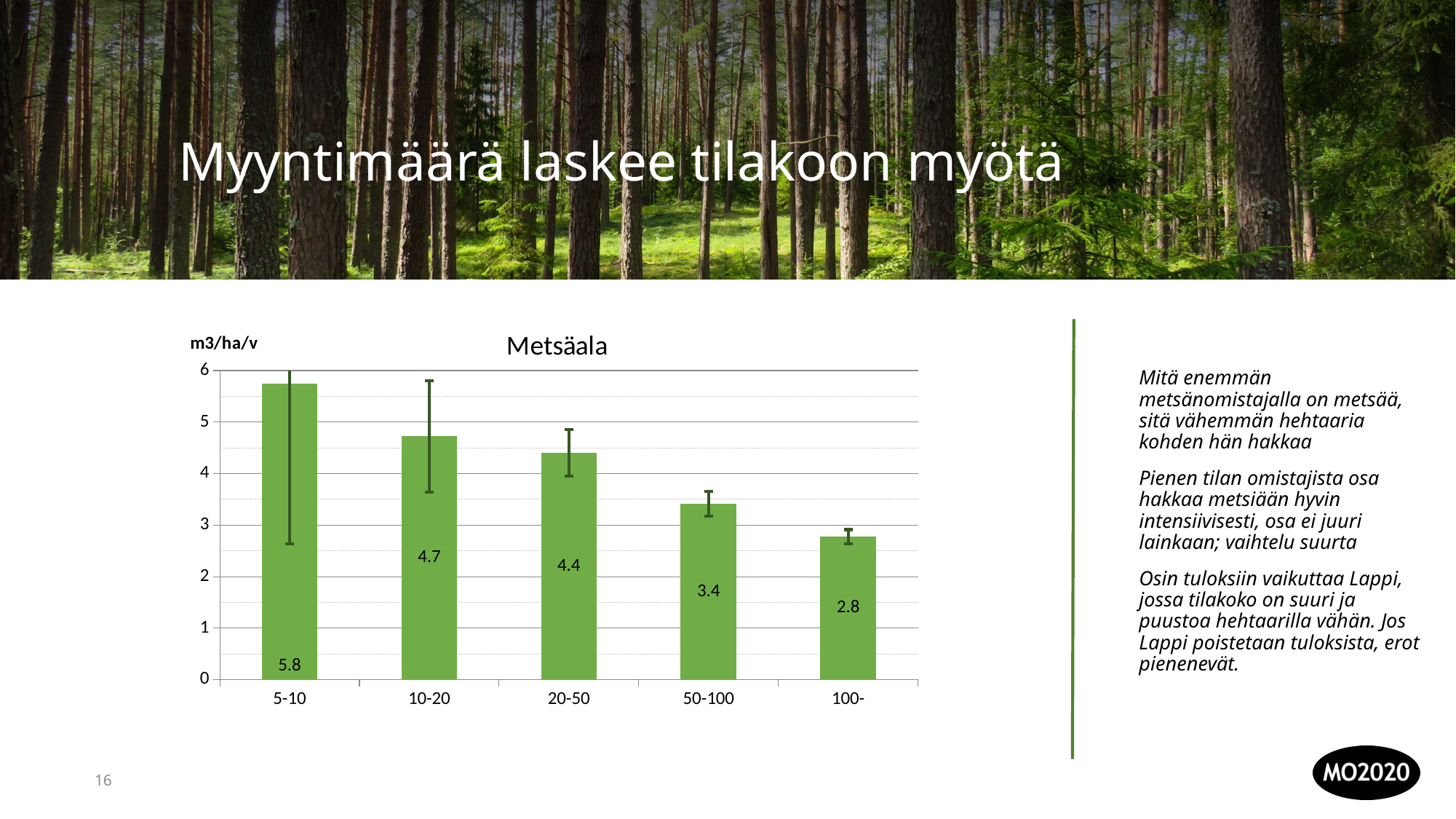
Do the values in the Metsäala chart rise or fall from left to right along the x axis? fall What is the value for the 50-100 category in the Metsäala chart? 3.4 What kind of chart is the Metsäala chart? bar chart What is the difference between the values for 5-10 and 100- in the Metsäala chart? 3.0 What is the value for the 5-10 category in the Metsäala chart? 5.8 Which is larger in the Metsäala chart, the value for 20-50 or the value for 50-100? 20-50 Which category has the lowest value in the Metsäala chart? 100- Which category has the highest value in the Metsäala chart? 5-10 How many categories are shown on the x axis of the Metsäala chart? 5 What is the value for the 100- category in the Metsäala chart? 2.8 What is the difference between the values for 10-20 and 20-50 in the Metsäala chart? 0.3 Is the value for 10-20 in the Metsäala chart greater or less than 4? greater